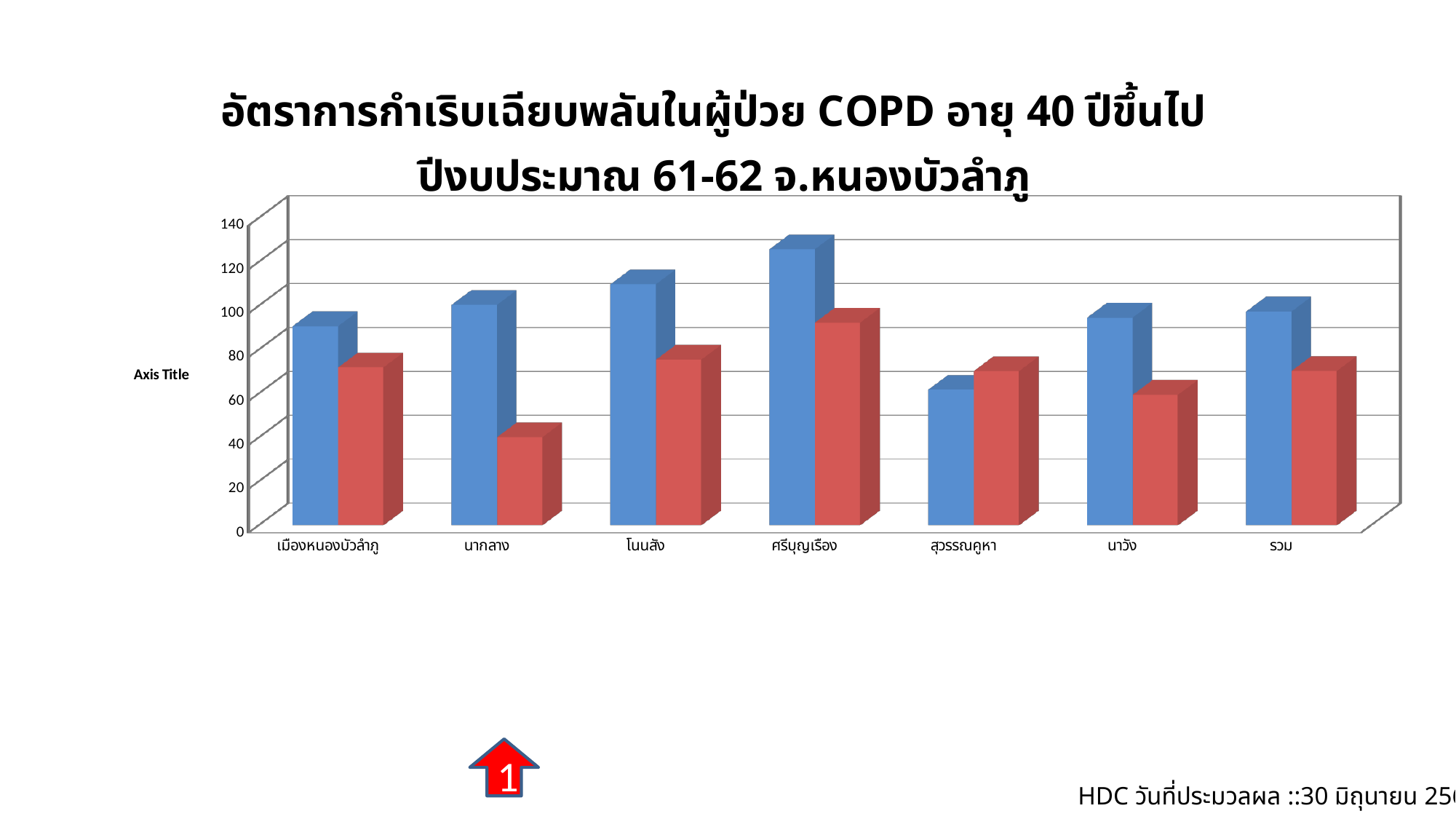
Which category has the tallest blue bar? ศรีบุญเรือง How many categories are shown along the x axis of the chart? 7 Is the value of the blue bar for สุวรรณคูหา greater or less than 80? less For นากลาง, which bar is taller, the blue one or the red one? blue Which category has the shortest blue bar? สุวรรณคูหา Is the value of the blue bar for ศรีบุญเรือง greater or less than 100? greater Is the value of the red bar for นากลาง greater or less than 60? less For สุวรรณคูหา, which bar is taller, the blue one or the red one? red What label is shown on the vertical axis of the chart? Axis Title What kind of chart is shown on the slide? bar chart Which category has the tallest red bar? ศรีบุญเรือง Which category has the shortest red bar? นากลาง